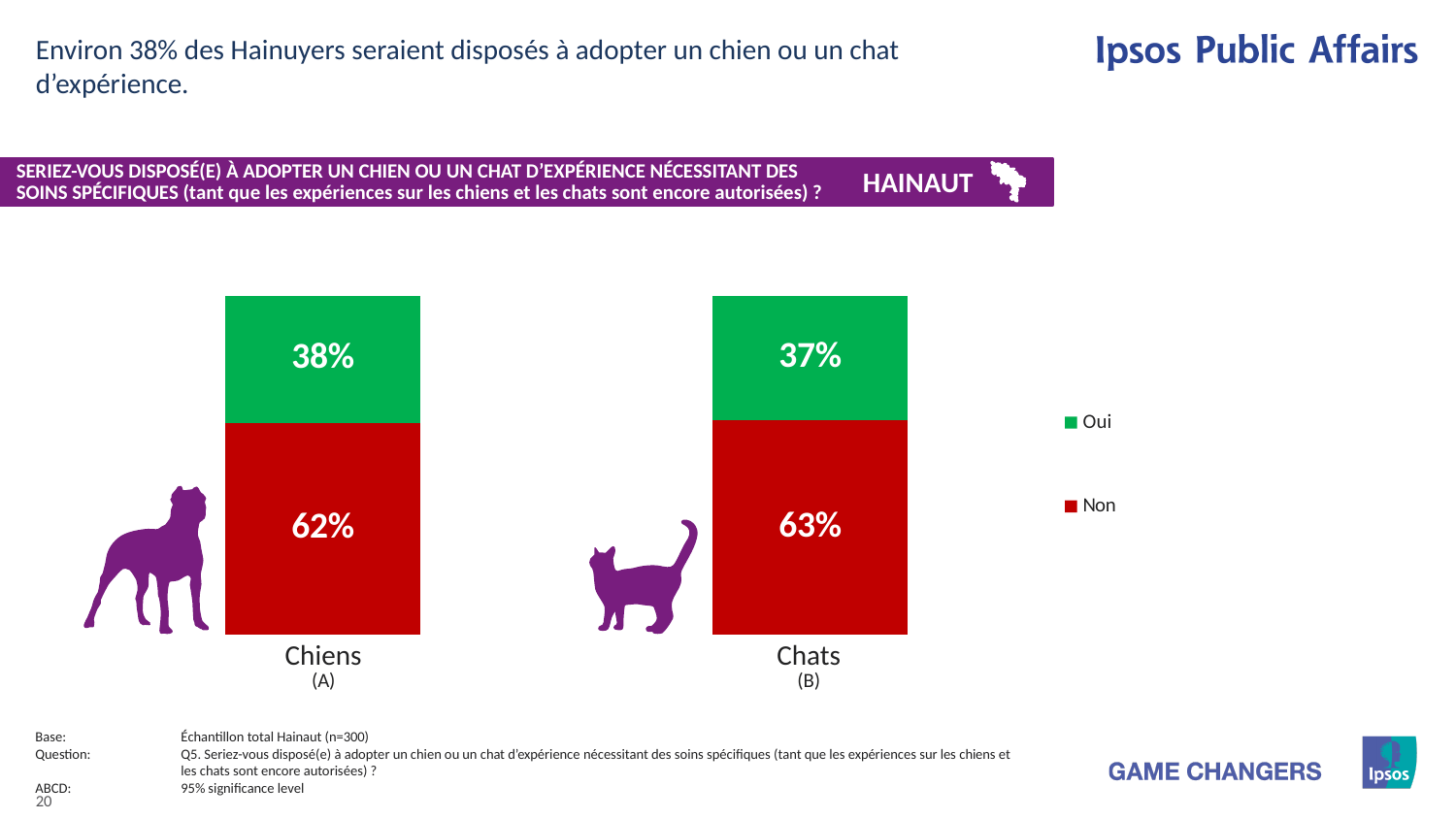
What is the difference between the 'Non' and 'Oui' values for Chiens? 24% Which category has the higher 'Non' value, Chiens or Chats? Chats How many series does the legend list? 2 What kind of chart is shown on the slide? Stacked bar chart What is the total of the stacked bar for Chats? 100% What is the 'Non' value for Chiens? 62% Which category has the higher 'Oui' value, Chiens or Chats? Chiens What is the 'Non' value for Chats? 63% What is the difference between the 'Non' value for Chats and the 'Non' value for Chiens? 1% What is the 'Oui' value for Chats? 37% How many categories are shown on the x axis? 2 What is the 'Oui' value for Chiens? 38%